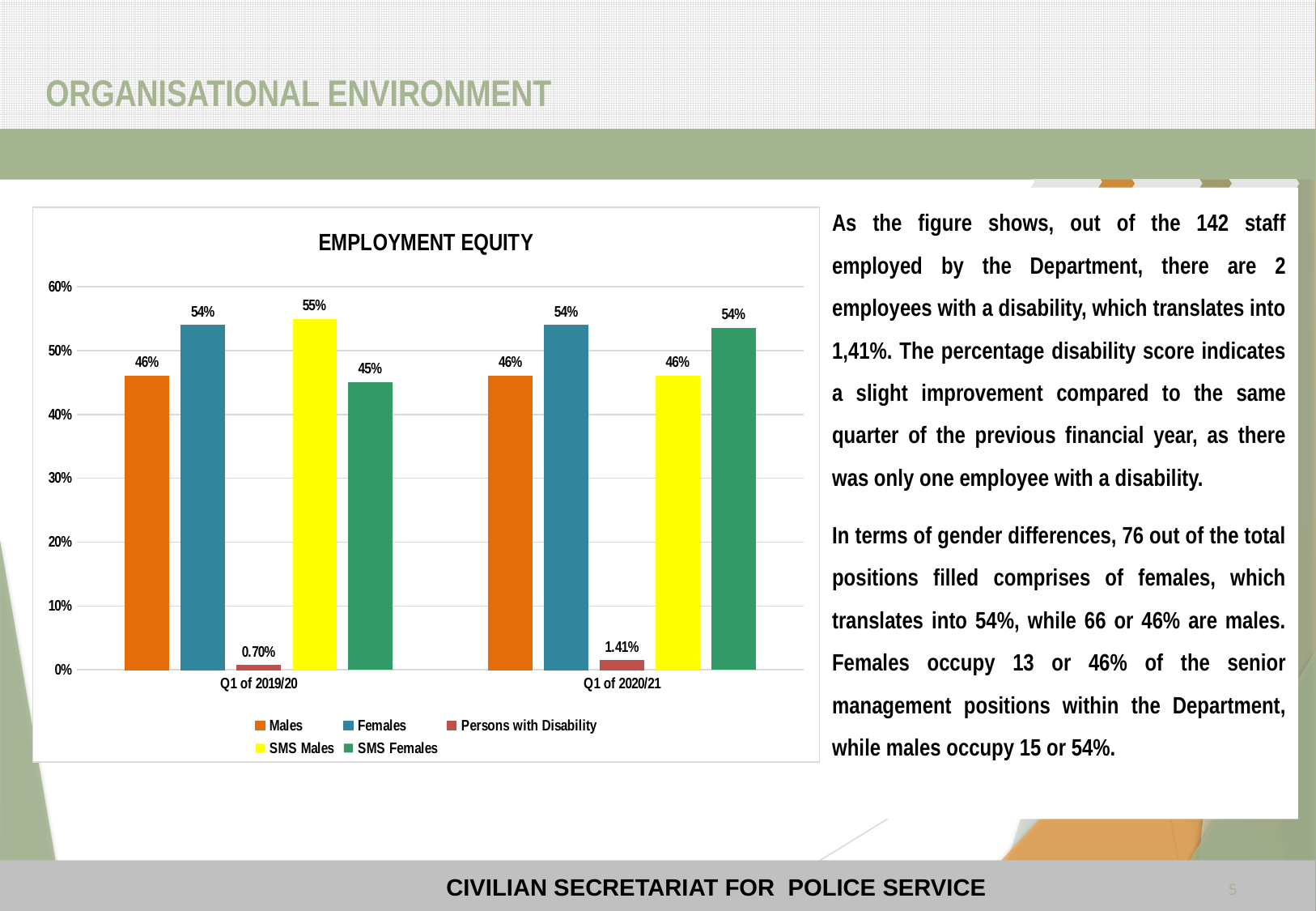
What is the value for SMS Females in Q1 of 2020/21? 54% What kind of chart is shown on the slide? Bar chart How many categories are shown on the x axis? 2 How many series does the legend list? 5 What is the difference between the Females value and the Males value in Q1 of 2020/21? 8% What is the value for Persons with Disability in Q1 of 2019/20? 0.70% What is the value for SMS Males in Q1 of 2019/20? 55% Which is larger in Q1 of 2019/20: SMS Males or SMS Females? SMS Males Which series has the highest value in Q1 of 2019/20? SMS Males What is the title of the chart? EMPLOYMENT EQUITY What is the value for Persons with Disability in Q1 of 2020/21? 1.41% Which series has the lowest value in Q1 of 2020/21? Persons with Disability